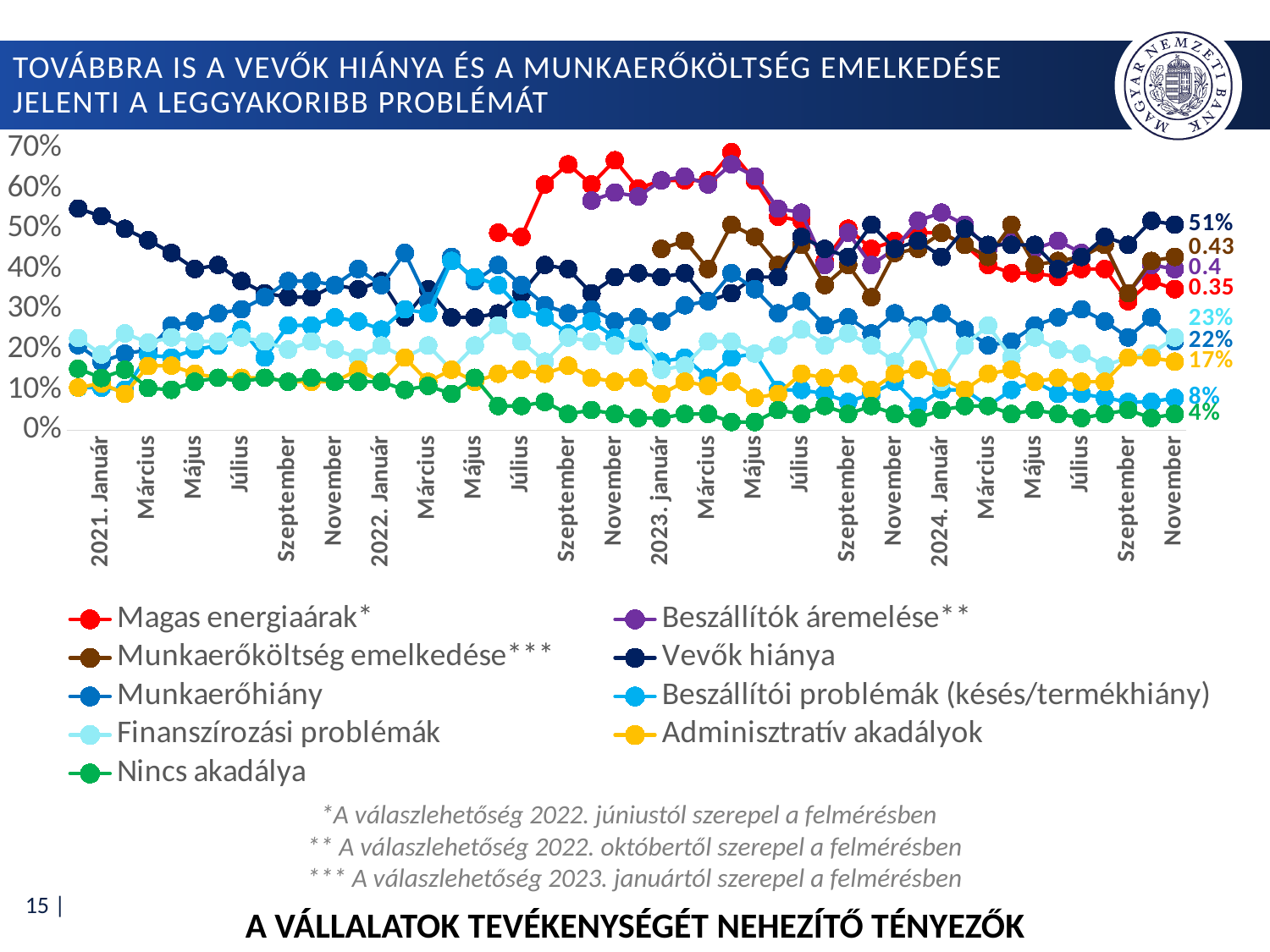
Which series has the lowest value at the last data point (November 2024)? Nincs akadálya What is the difference between the last values of Finanszírozási problémák (23%) and Beszállítói problémák (8%)? 15% What is the value for Vevők hiánya at the last data point (November 2024)? 51% What is the value for Munkaerőköltség emelkedése at the last data point (November 2024)? 0.43 At the last data point, which is larger: Munkaerőhiány or Adminisztratív akadályok? Munkaerőhiány What is the value for Finanszírozási problémák at the last data point (November 2024)? 23% Which series has the highest value at the last data point (November 2024)? Vevők hiánya What is the value for Magas energiaárak at the last data point (November 2024)? 0.35 Is the value for Vevők hiánya in 2021. Január greater or less than 50%? greater What is the value for Nincs akadálya at the last data point (November 2024)? 4% What kind of chart is shown on the slide? line chart How many series does the legend list? 9